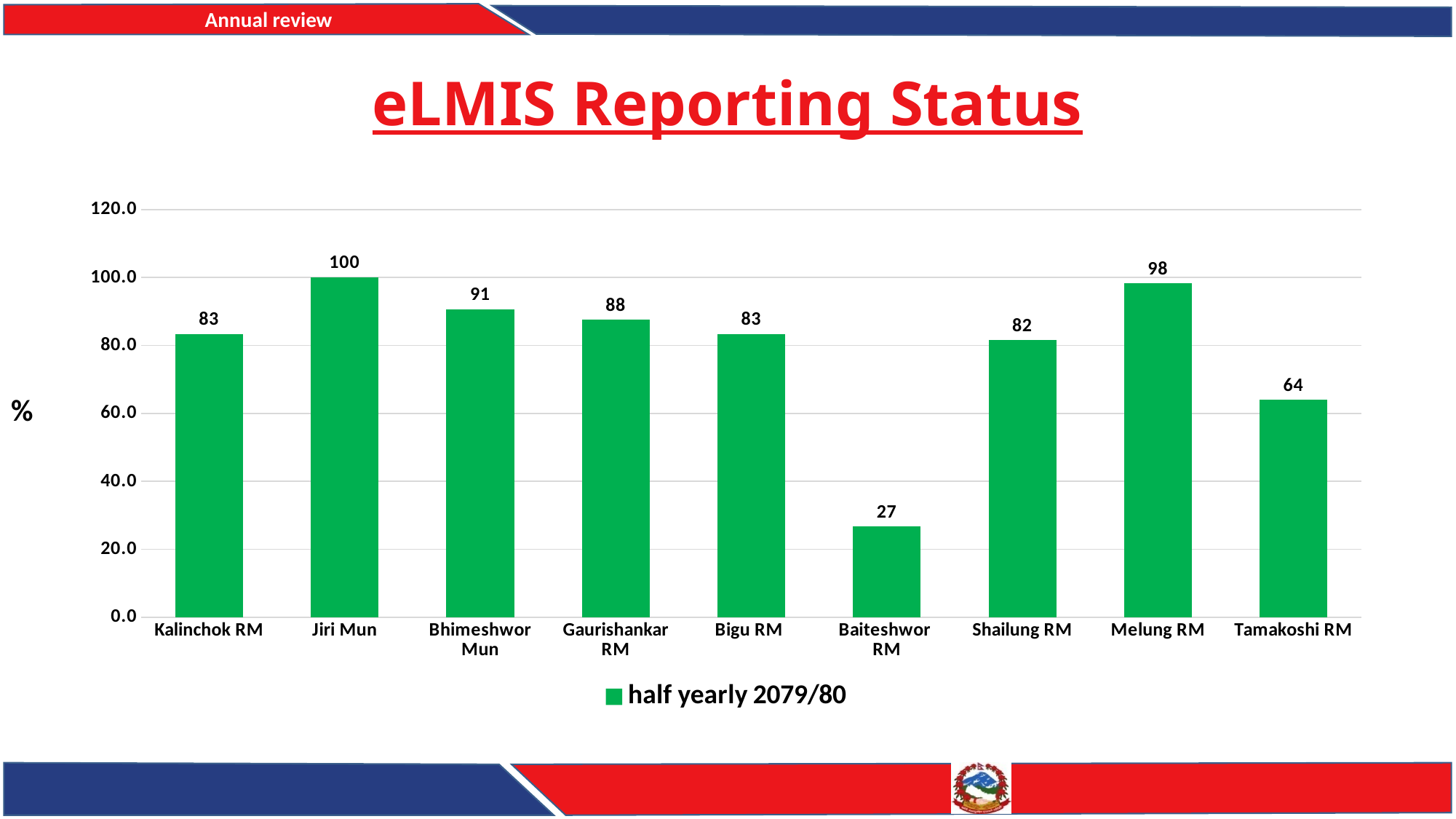
Which category has the highest value? Jiri Mun What series does the legend list? half yearly 2079/80 What is the value for Melung RM? 98 What is the value for Tamakoshi RM? 64 What kind of chart is shown on the slide? Bar chart What is the difference between the values for Jiri Mun and Baiteshwor RM? 73 What is the value for Jiri Mun? 100 Which category has the lowest value? Baiteshwor RM What is the difference between the values for Bhimeshwor Mun and Gaurishankar RM? 3 What is the value for Baiteshwor RM? 27 How many categories are shown on the x axis? 9 Which is larger, the value for Melung RM or the value for Tamakoshi RM? Melung RM